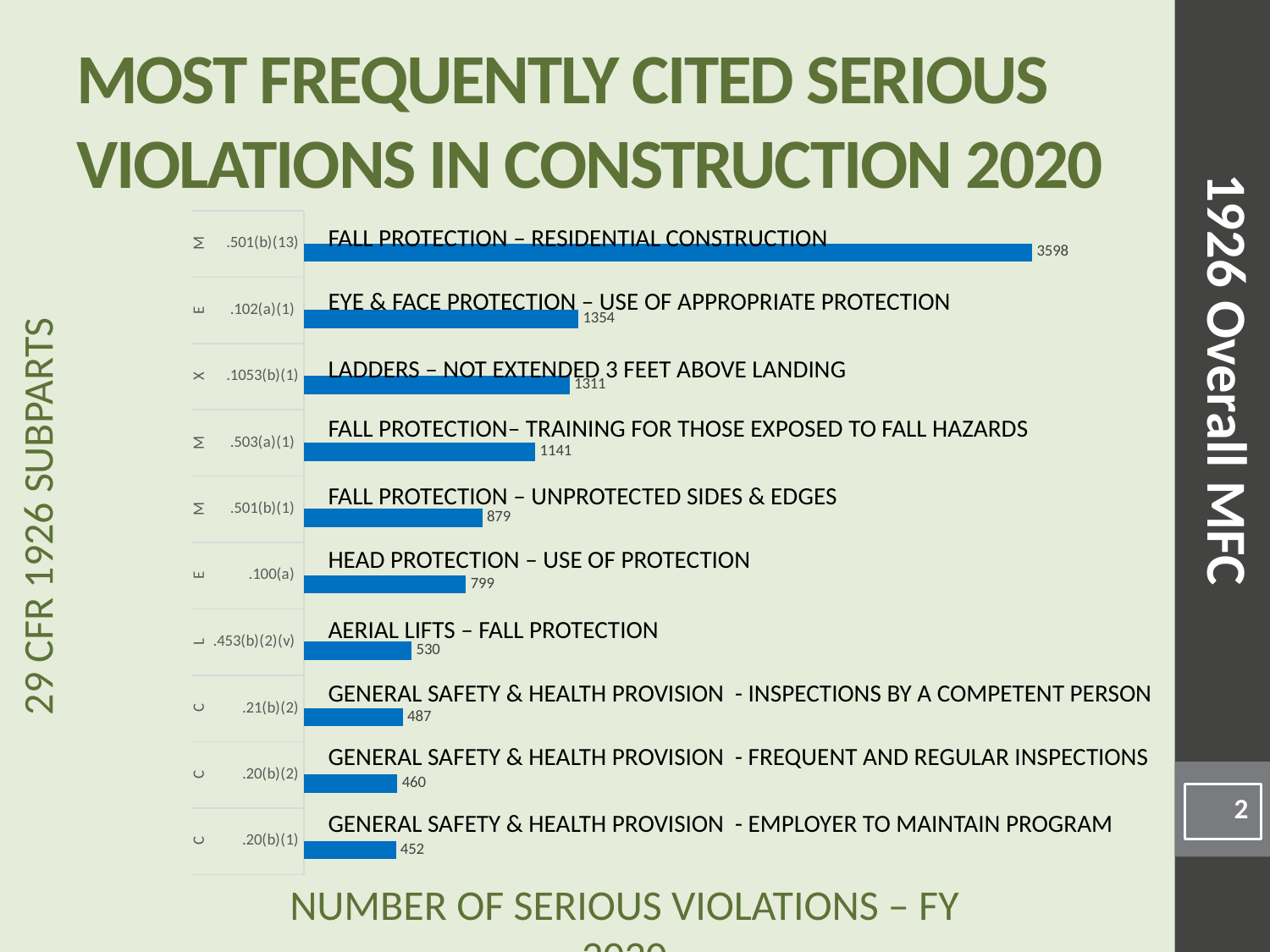
Which violation category has the highest number of serious violations? .501(b)(13) Fall Protection – Residential Construction What type of chart is shown on the slide? Bar chart Which violation category has the lowest number of serious violations? .20(b)(1) General Safety & Health Provision - Employer to Maintain Program What is the axis title shown below the chart? Number of Serious Violations – FY 2020 What is the difference in serious violations between .102(a)(1) Eye & Face Protection and .1053(b)(1) Ladders? 43 What is the number of serious violations for .1053(b)(1) Ladders – Not Extended 3 Feet Above Landing? 1311 Which has more serious violations: .503(a)(1) Fall Protection – Training or .501(b)(1) Fall Protection – Unprotected Sides & Edges? .503(a)(1) Fall Protection – Training What is the number of serious violations for .501(b)(13) Fall Protection – Residential Construction? 3598 What is the number of serious violations for .100(a) Head Protection – Use of Protection? 799 How many violation categories are plotted in the chart? 10 What is the difference in serious violations between .501(b)(13) Fall Protection – Residential Construction and .102(a)(1) Eye & Face Protection? 2244 What is the number of serious violations for .453(b)(2)(v) Aerial Lifts – Fall Protection? 530